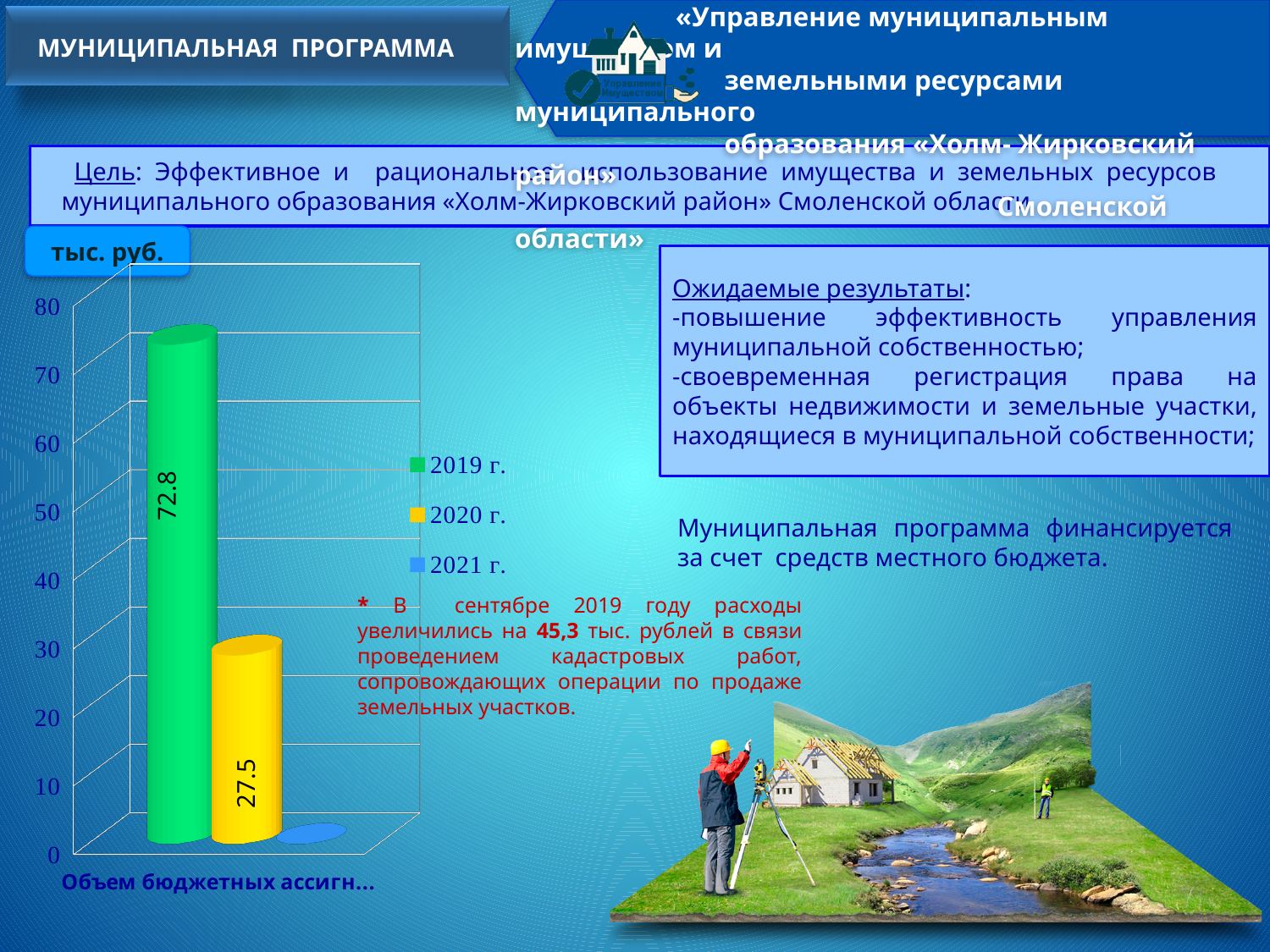
What is the value for 2019 г. in the bar chart? 72.8 Which year has the highest value in the bar chart? 2019 г. Which year has the lowest value in the bar chart? 2021 г. What is the difference between the values for 2019 г. and 2020 г. in the bar chart? 45.3 How many series does the legend of the bar chart list? 3 Which is larger in the bar chart, the value for 2019 г. or the value for 2020 г.? 2019 г. What is the value for 2020 г. in the bar chart? 27.5 Is the value for 2019 г. in the bar chart greater or less than 70? greater What unit is shown in the label above the chart? тыс. руб. Is the value for 2020 г. in the bar chart greater or less than 30? less What colour is the bar for 2019 г. in the chart? green What kind of chart is shown on the slide? bar chart